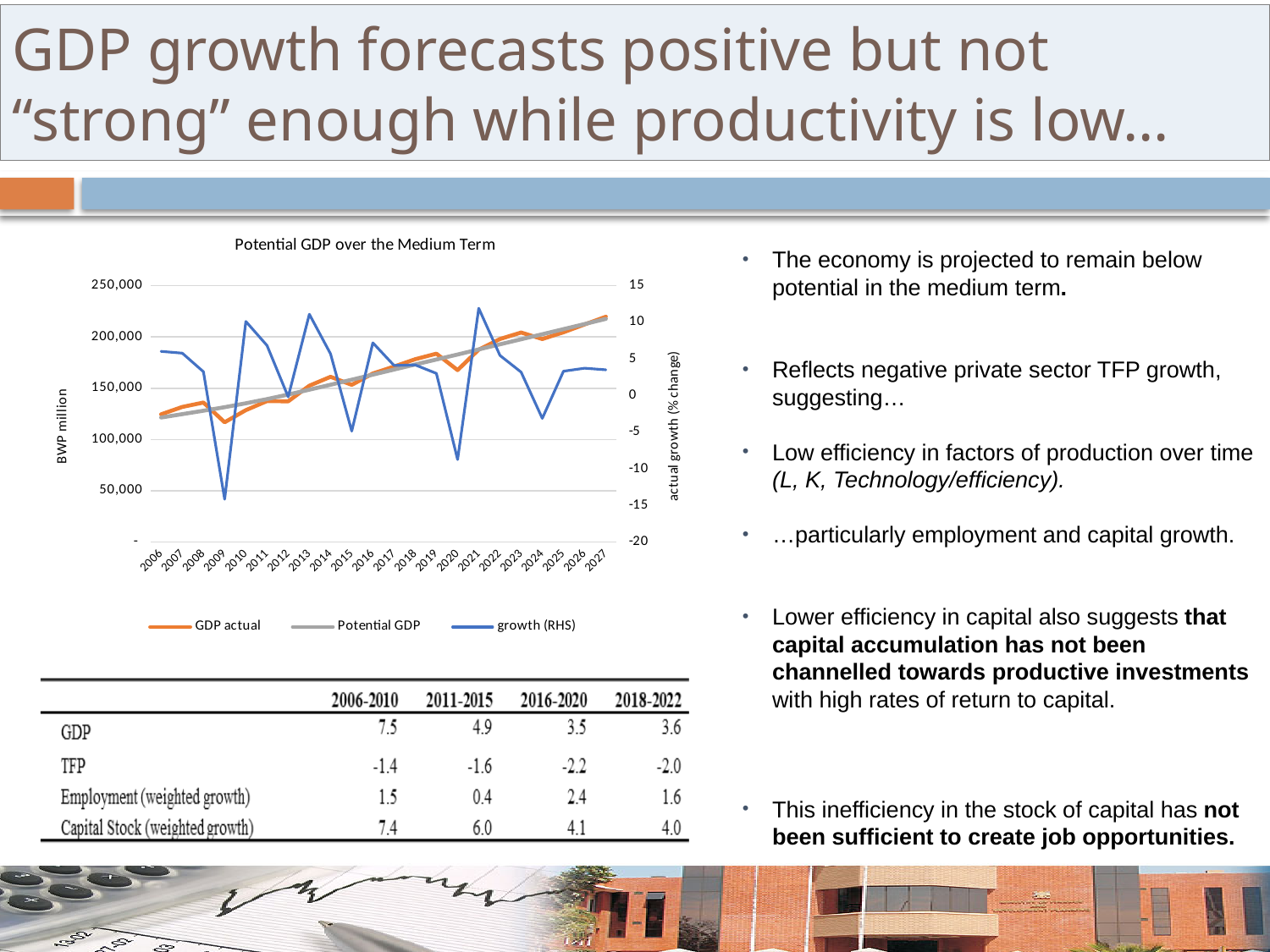
What is the title of the chart on the slide? Potential GDP over the Medium Term Does the Potential GDP series rise or fall from 2006 to 2027? rise Is the value for growth (RHS) in 2021 greater or less than 5? greater Is the value for GDP actual in 2006 greater or less than 150,000? less How many years are shown along the x axis of the chart? 22 What is the label of the left vertical axis of the chart? BWP million In which year is the growth (RHS) series at its lowest? 2009 How many series does the chart's legend list? 3 What kind of chart is shown on the slide? line chart In 2009, which is larger: GDP actual or Potential GDP? Potential GDP Is the value for growth (RHS) in 2009 greater or less than -10? less